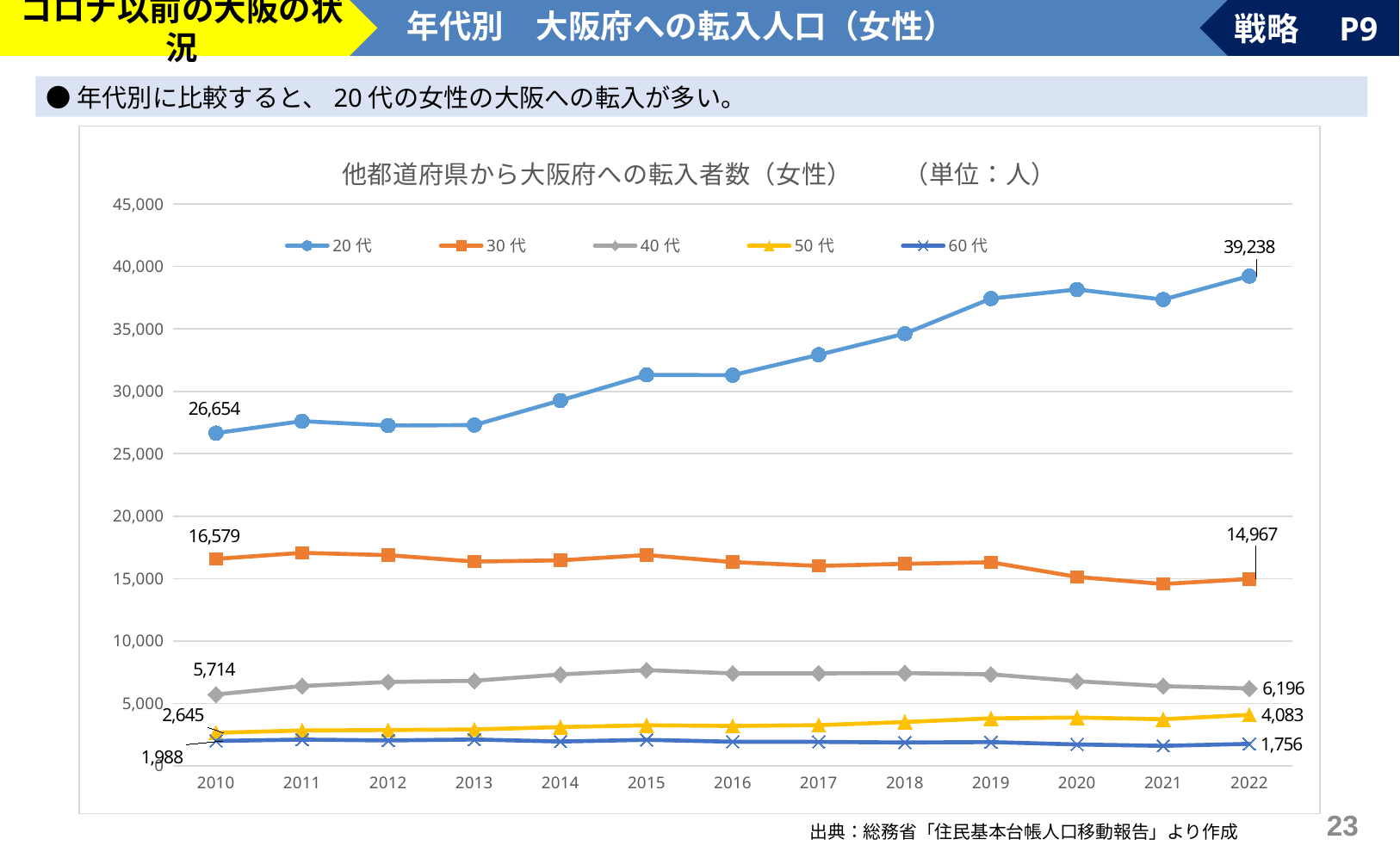
What type of chart is shown on the slide? line chart How many series does the legend list? 5 What is the value for 30代 in 2010? 16,579 Which series has the lowest value in 2010? 60代 How many years are plotted along the x axis? 13 What is the value for 60代 in 2022? 1,756 Which series has the highest value in 2022? 20代 Which is larger, the 50代 value in 2022 or the 40代 value in 2022? 40代 value in 2022 Does the 30代 series rise or fall from 2010 to 2022? fall What is the value for 20代 in 2022? 39,238 Is the value for 20代 in 2016 greater or less than 30,000? greater What is the difference between the 20代 values in 2022 and 2010? 12,584